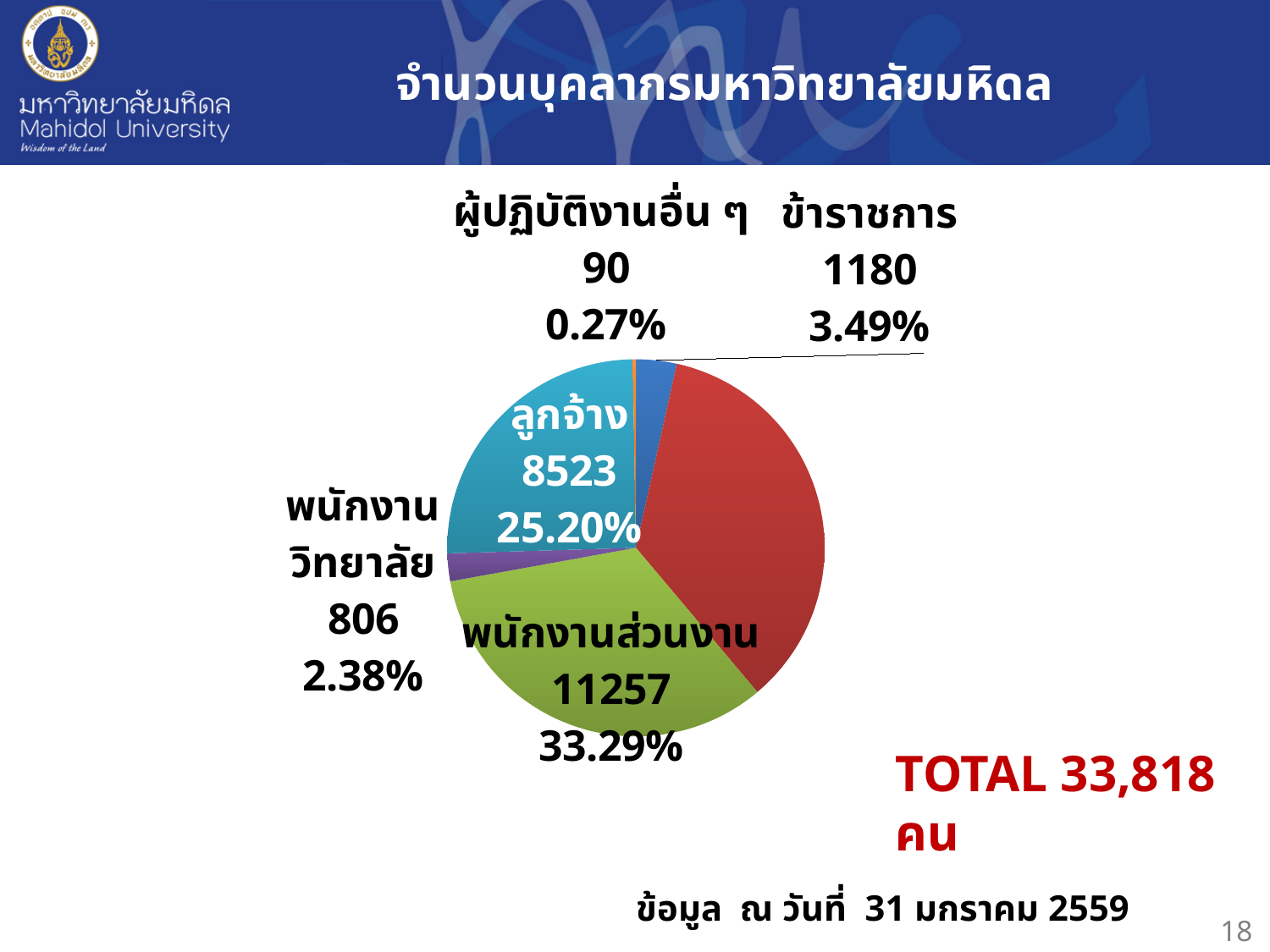
What total number of people is stated on the slide? 33,818 คน How many people are in the พนักงานส่วนงาน category? 11257 What kind of chart is shown on the slide? Pie chart Which is larger, ข้าราชการ or พนักงานวิทยาลัย? ข้าราชการ What is the difference between the values for พนักงานส่วนงาน and ลูกจ้าง? 2734 How many people are in the ข้าราชการ category? 1180 How many people are in the ลูกจ้าง category? 8523 What percentage share does ลูกจ้าง have in the pie? 25.20% What is the difference between the values for ข้าราชการ and พนักงานวิทยาลัย? 374 What is the title of the chart? จำนวนบุคลากรมหาวิทยาลัยมหิดล What percentage share does พนักงานวิทยาลัย have in the pie? 2.38% Which labeled category has the smallest value? ผู้ปฏิบัติงานอื่น ๆ